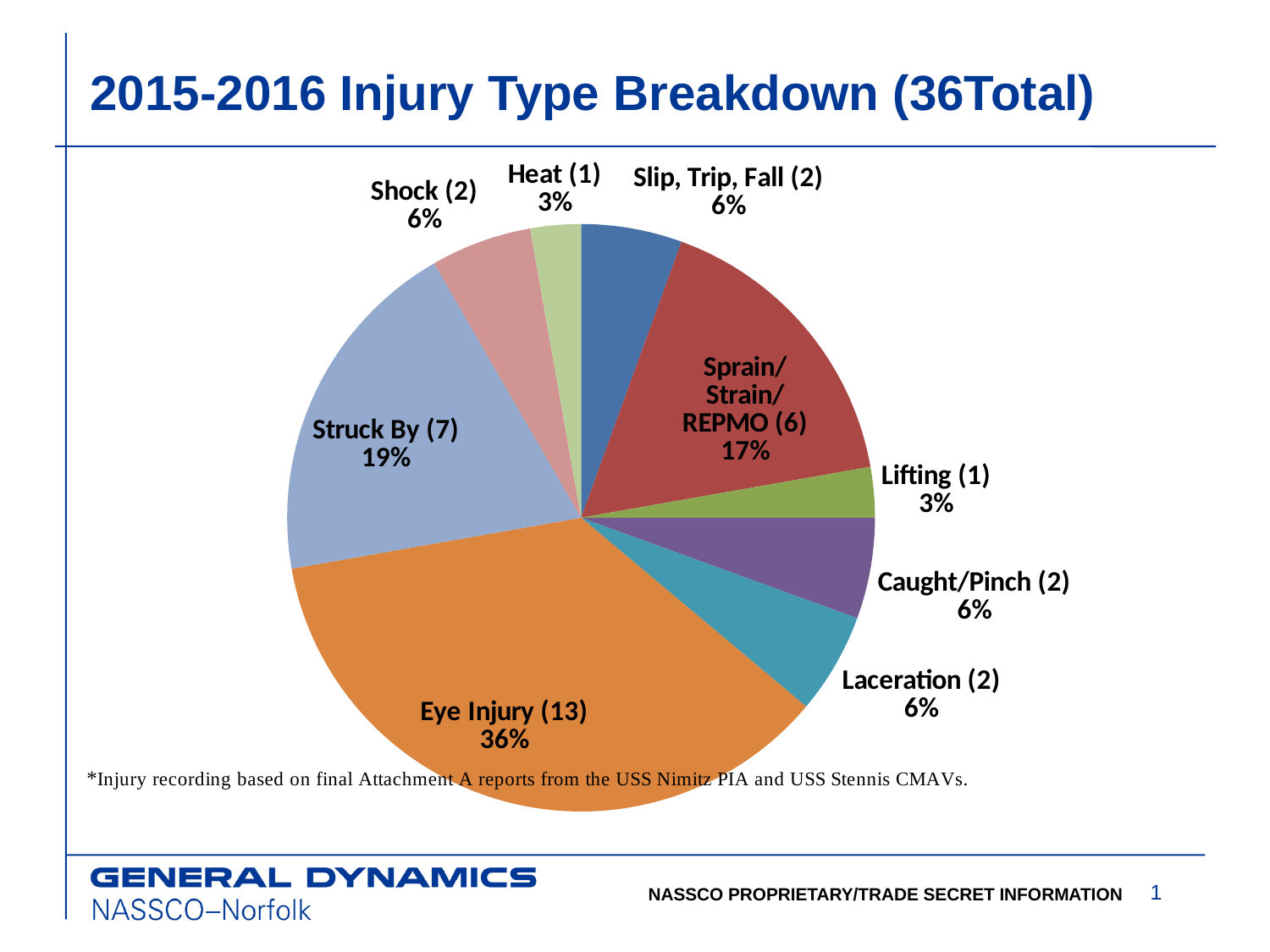
What percentage share does Eye Injury have in the pie chart? 36% What kind of chart is shown on the slide? pie chart What is the total number of injuries stated in the chart title? 36 How many injuries are attributed to Laceration? 2 Which injury type has the largest slice of the pie? Eye Injury What is the difference in injury count between Eye Injury and Struck By? 6 Which has more injuries, Sprain/Strain/REPMO or Struck By? Struck By How many injury categories are shown in the pie chart? 9 What percentage share does Heat have in the pie chart? 3% What is the combined number of injuries for Shock and Slip, Trip, Fall? 4 How many injuries are attributed to Struck By? 7 What percentage share does Sprain/Strain/REPMO have? 17%